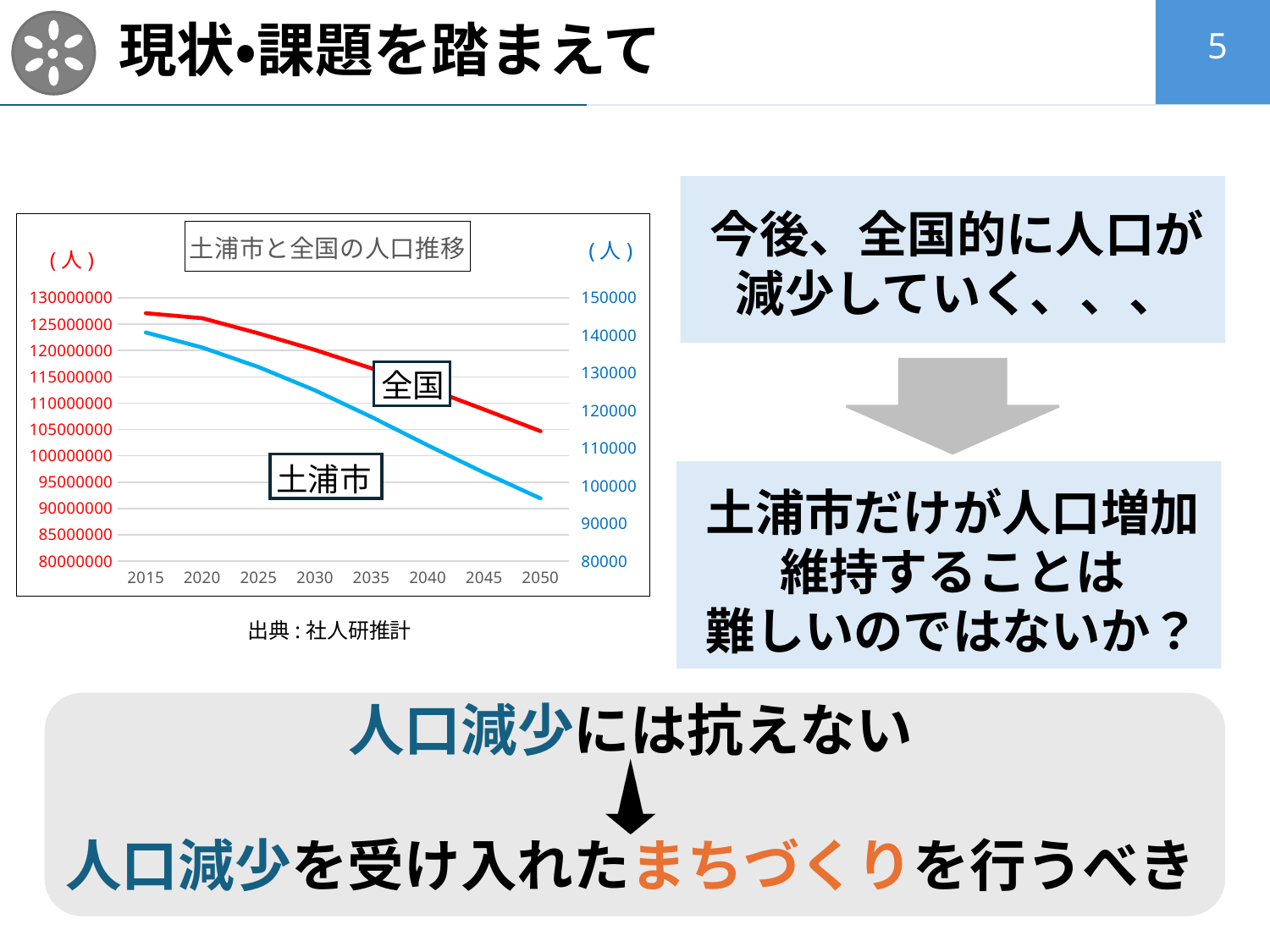
What is the title of the chart? 土浦市と全国の人口推移 Is the value for 全国 in 2015 greater or less than 125000000? greater What colour is the 全国 line in the chart? red Does the 全国 line rise or fall from 2015 to 2050? fall Is the value for 土浦市 in 2050 greater or less than 110000? less Is the value for 全国 in 2050 greater or less than 100000000? greater What kind of chart is shown on the slide? line chart Does the 土浦市 line rise or fall from 2015 to 2050? fall What is the first year shown on the x axis of the chart? 2015 How many year ticks are shown on the x axis of the chart? 8 How many series are plotted in the chart? 2